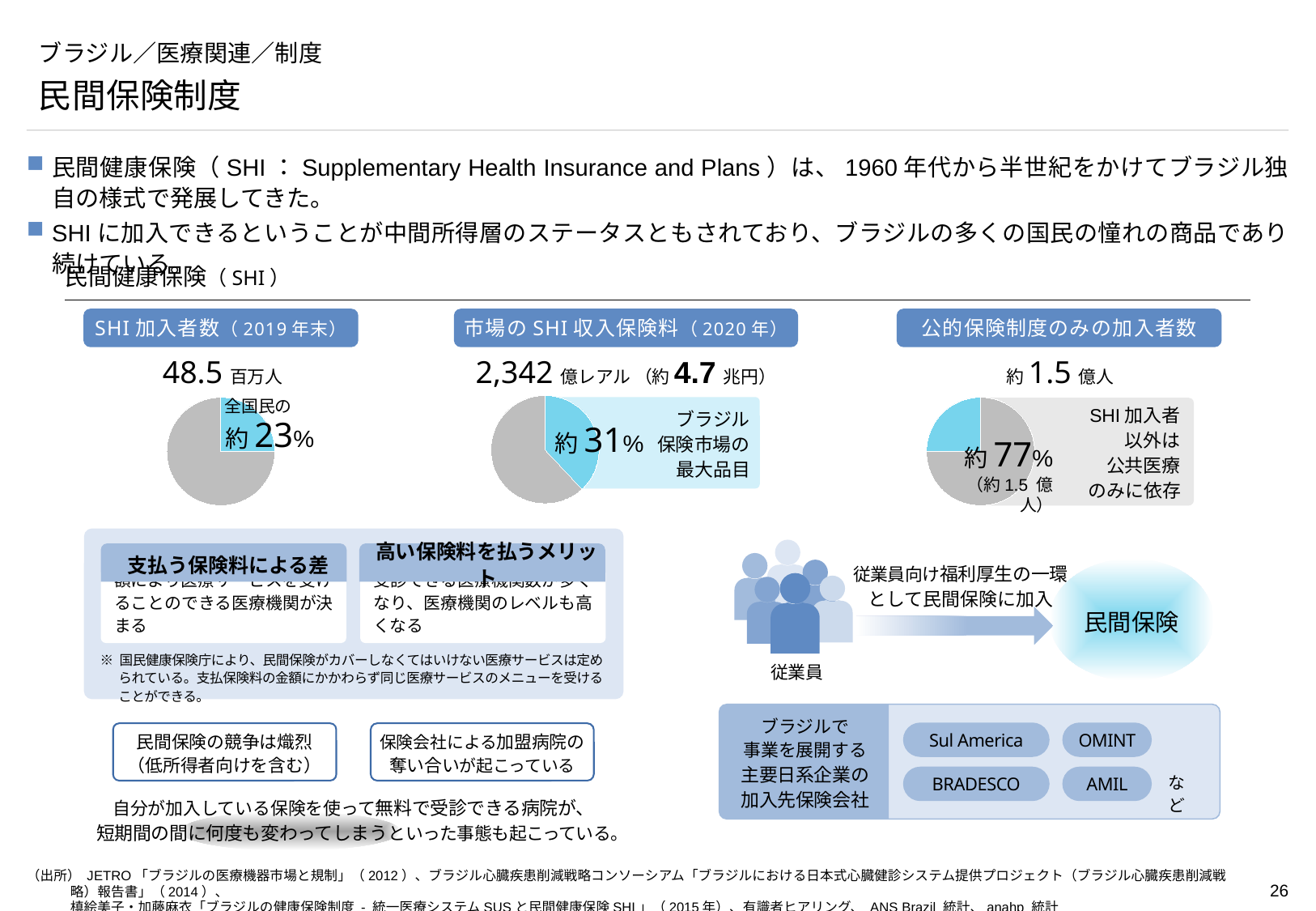
What colour is used for the highlighted slice in the pie charts? light blue How many slices does each pie chart on the slide have? 2 In the pie chart under 'SHI 加入者数（2019 年末）', what share of the whole population is shown for the highlighted slice? 約23% Which of the three pie charts has the largest highlighted slice? 市場の SHI 収入保険料（2020 年） Is the highlighted slice in the '市場の SHI 収入保険料（2020 年）' pie chart larger or smaller than the highlighted slice in the 'SHI 加入者数（2019 年末）' pie chart? larger In the pie chart under 'SHI 加入者数（2019 年末）', is the highlighted slice greater or less than 50%? less How many pie charts are shown on the slide? 3 In the pie chart under '市場の SHI 収入保険料（2020 年）', what percentage is printed for the highlighted slice? 約31% What kind of chart is shown under the heading 'SHI 加入者数（2019 年末）'? pie chart In the pie chart under '公的保険制度のみの加入者数', is the highlighted slice greater or less than 50%? less